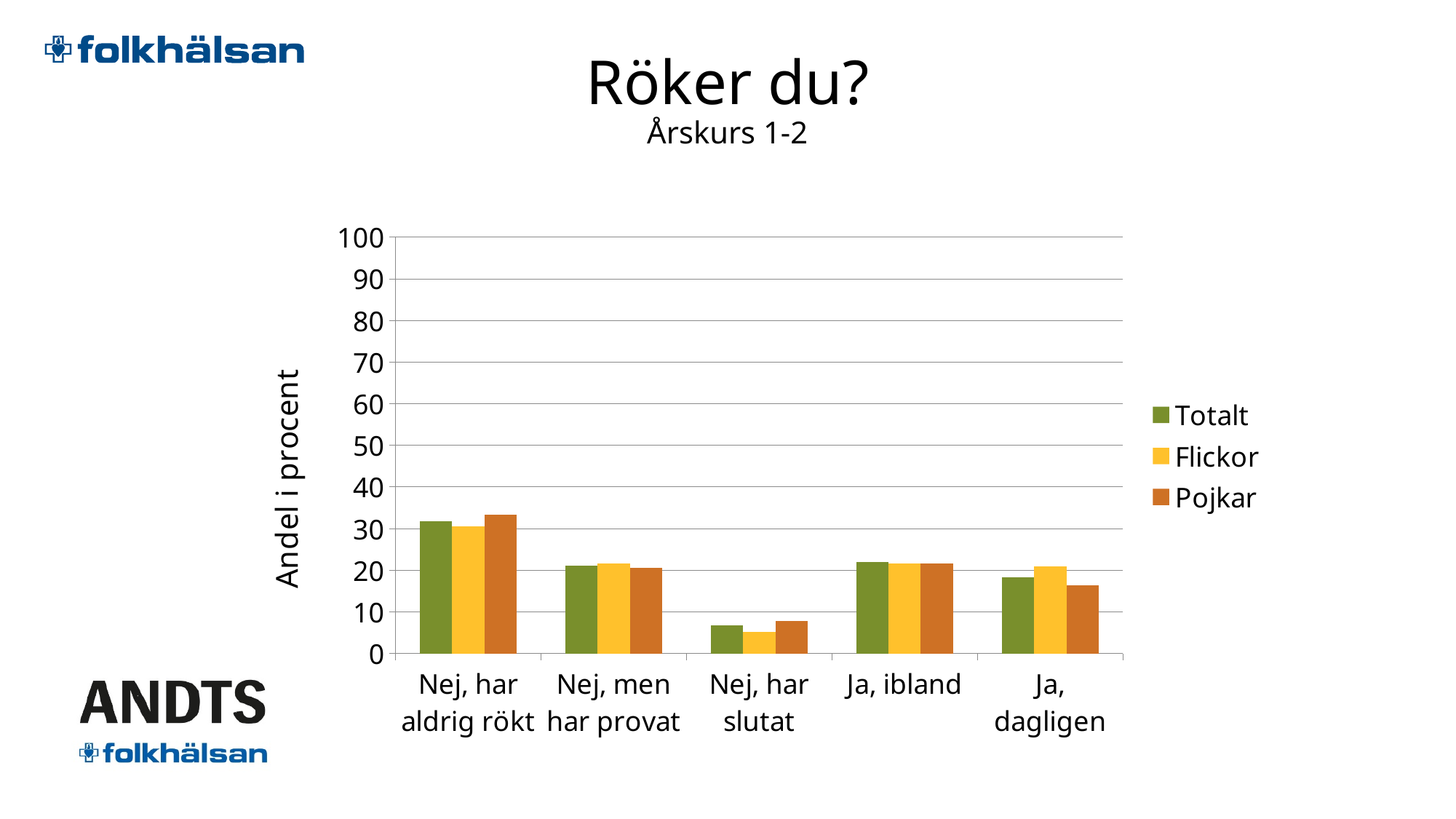
Is the value for Totalt in 'Nej, har aldrig rökt' greater or less than 20? greater Is the value for Flickor in 'Nej, har slutat' greater or less than 10? less How many categories are shown on the x axis? 5 Is the value for Pojkar in 'Nej, har aldrig rökt' greater or less than 40? less What kind of chart is shown on the slide? bar chart Which category has the lowest value for Flickor? Nej, har slutat What is the label of the y axis? Andel i procent Which is larger: Pojkar in 'Nej, har aldrig rökt' or Pojkar in 'Nej, har slutat'? Pojkar in 'Nej, har aldrig rökt' How many series does the legend list? 3 In the 'Ja, dagligen' category, which is larger: Flickor or Pojkar? Flickor Which category has the highest value for Totalt? Nej, har aldrig rökt